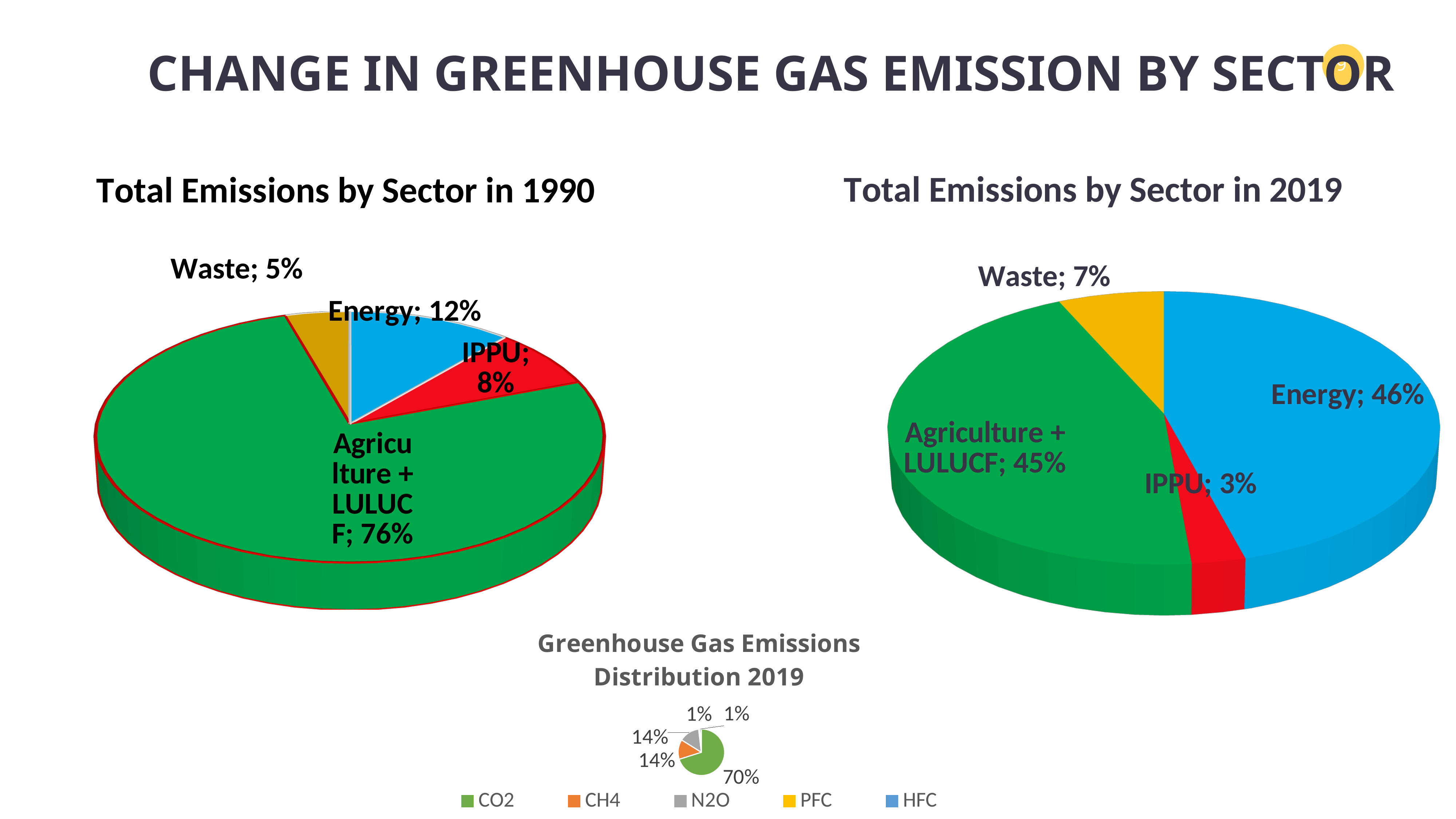
In the 'Total Emissions by Sector in 1990' chart, how many sectors are shown? 4 In the 'Greenhouse Gas Emissions Distribution 2019' chart, how many gases does the legend list? 5 In the 'Total Emissions by Sector in 2019' chart, is the Waste share larger or smaller than the IPPU share? larger What kind of chart is 'Total Emissions by Sector in 1990'? Pie chart In the 'Total Emissions by Sector in 1990' chart, what is the value for Energy? 12% In the 'Total Emissions by Sector in 1990' chart, what is the difference between the Energy share and the IPPU share? 4% In the 'Total Emissions by Sector in 1990' chart, what share does Agriculture + LULUCF have? 76% In the 'Total Emissions by Sector in 2019' chart, what is the difference between the Energy share and the Agriculture + LULUCF share? 1% In the 'Greenhouse Gas Emissions Distribution 2019' chart, what share does CO2 have? 70% In the 'Total Emissions by Sector in 2019' chart, which sector has the largest share? Energy In the 'Total Emissions by Sector in 1990' chart, which sector has the smallest share? Waste In the 'Total Emissions by Sector in 2019' chart, what is the value for IPPU? 3%